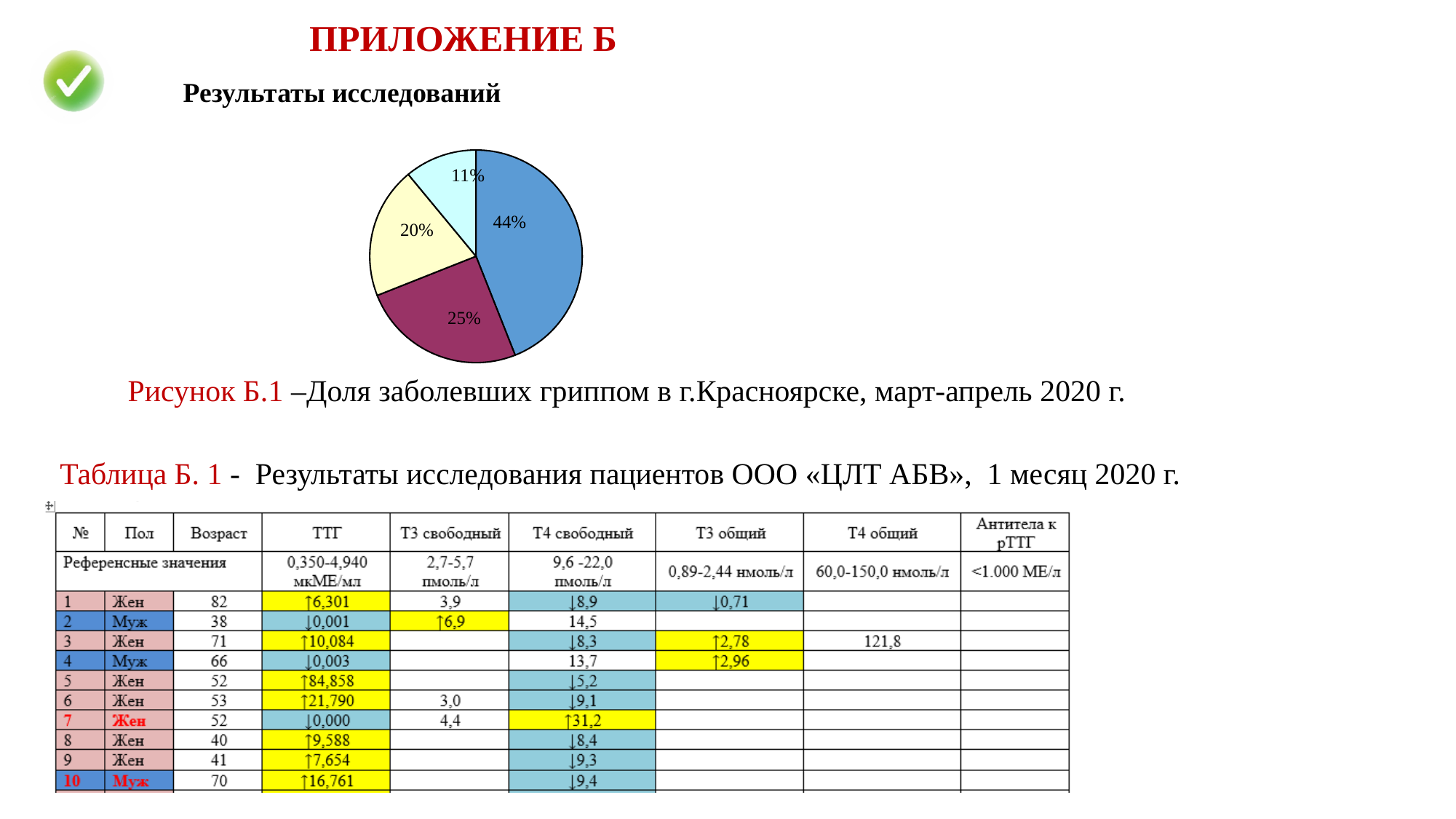
What is the caption of the pie chart figure? Рисунок Б.1 – Доля заболевших гриппом в г.Красноярске, март-апрель 2020 г. What is the largest share shown in the pie chart? 44% Does the pie chart include a legend? No How many slices does the pie chart have? 4 What percentage is shown on the blue slice of the pie chart? 44% Which slice is larger in the pie chart, the magenta one or the light yellow one? the magenta one (25%) What is the smallest share shown in the pie chart? 11% What kind of chart is shown in Рисунок Б.1? pie chart What percentage is shown on the dark magenta slice of the pie chart? 25% What percentage is shown on the light cyan slice of the pie chart? 11% What percentage is shown on the light yellow slice of the pie chart? 20% What is the difference between the largest and smallest slices of the pie chart? 33 percentage points